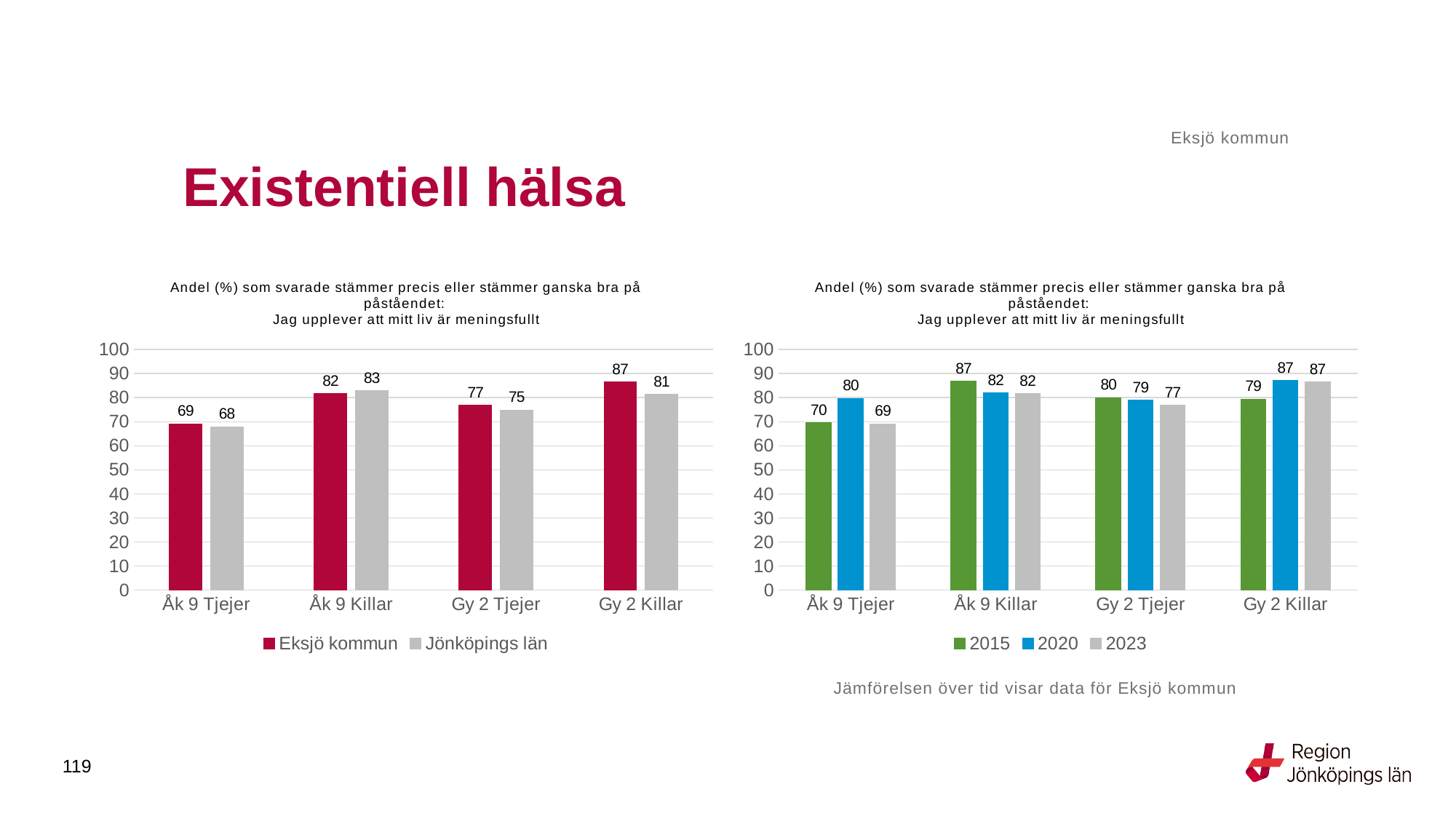
In the right chart, what is the value for 2023 for Gy 2 Tjejer? 77 In the left chart, what is the value for Eksjö kommun for Åk 9 Tjejer? 69 In the right chart, what is the value for 2020 for Åk 9 Tjejer? 80 In the right chart, what is the difference between 2015 and 2023 for Åk 9 Killar? 5 In the left chart, how many series does the legend list? 2 In the left chart, what is the difference between Eksjö kommun and Jönköpings län for Gy 2 Killar? 6 In the left chart, which category has the lowest value for Jönköpings län? Åk 9 Tjejer In the left chart, which category has the highest value for Eksjö kommun? Gy 2 Killar In the right chart, how many categories are shown on the x axis? 4 What kind of chart is the right chart? Bar chart In the left chart, what is the value for Jönköpings län for Gy 2 Killar? 81 In the right chart, which is larger for Gy 2 Killar: 2015 or 2023? 2023